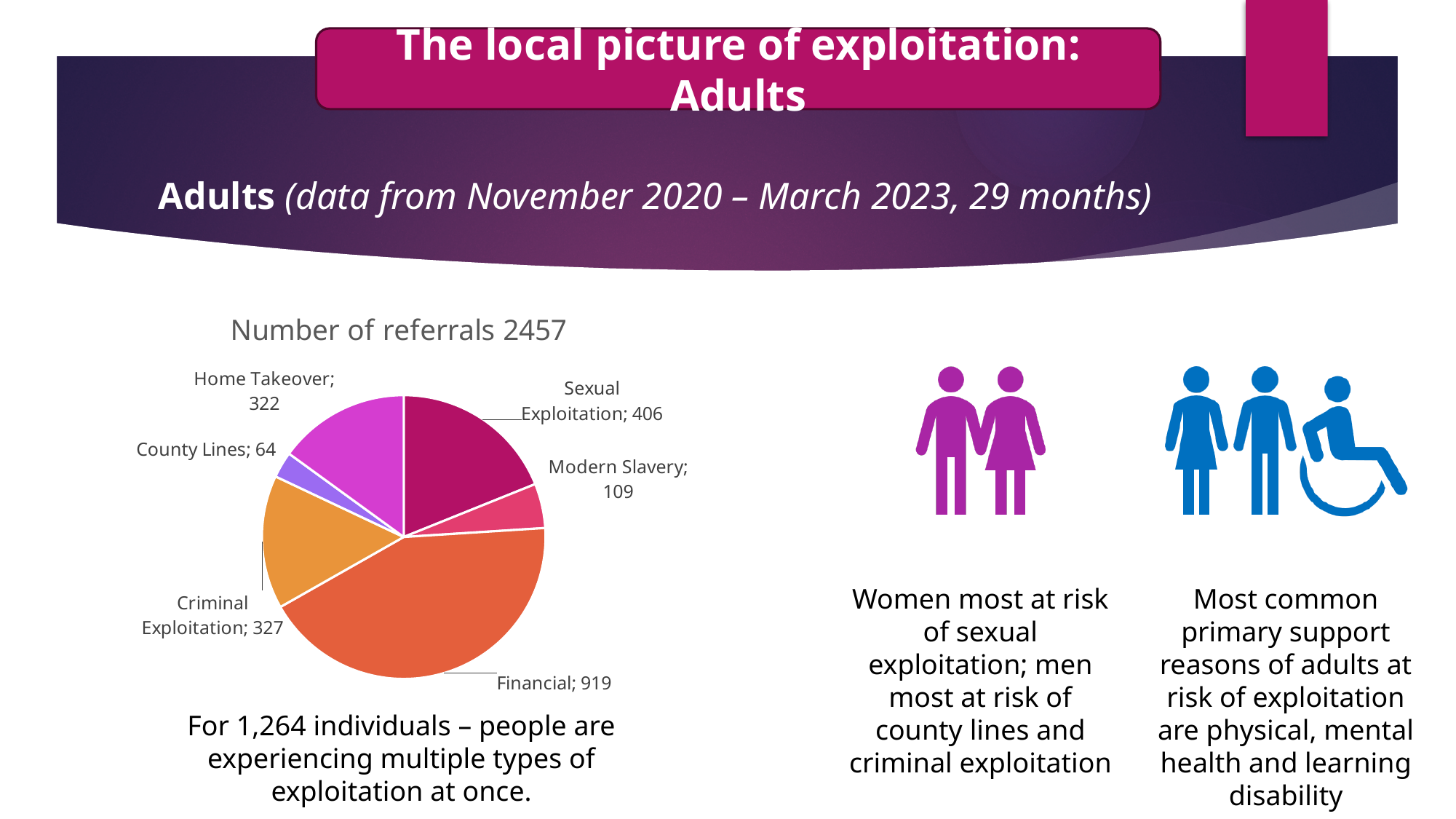
What is the value for Sexual Exploitation? 406 Which category has the largest slice? Financial What is the value for Financial? 919 Which is larger, Home Takeover or Modern Slavery? Home Takeover Which category has the smallest slice? County Lines What is the title of the chart? Number of referrals 2457 What is the value for County Lines? 64 What type of chart is shown on the slide? pie chart How many categories does the pie chart show? 6 What is the difference between Financial and Sexual Exploitation? 513 What is the value for Modern Slavery? 109 What is the difference between Criminal Exploitation and County Lines? 263